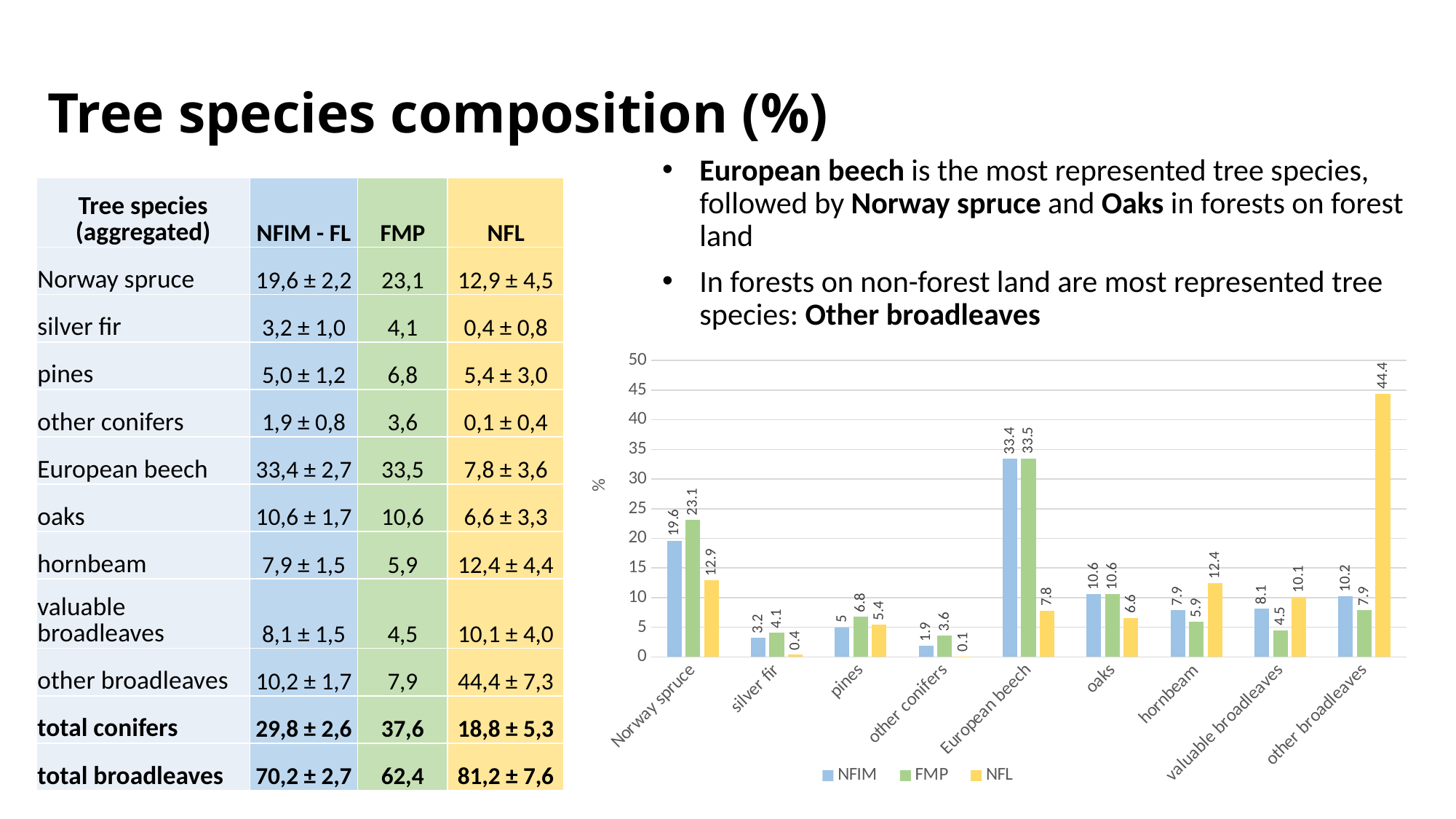
What kind of chart is shown on the slide? bar chart How many series does the chart legend list? 3 What is the FMP value for Norway spruce? 23.1 What is the NFIM value for European beech? 33.4 What is the NFL value for other broadleaves? 44.4 Which tree species has the highest NFIM value? European beech For hornbeam, which is larger: the NFIM value or the NFL value? NFL Which tree species has the lowest NFL value? other conifers Which tree species has the highest NFL value? other broadleaves Is the NFL value for other broadleaves greater or less than 40? greater How many tree species categories are shown on the x axis of the chart? 9 What is the difference between the NFL and NFIM values for other broadleaves? 34.2